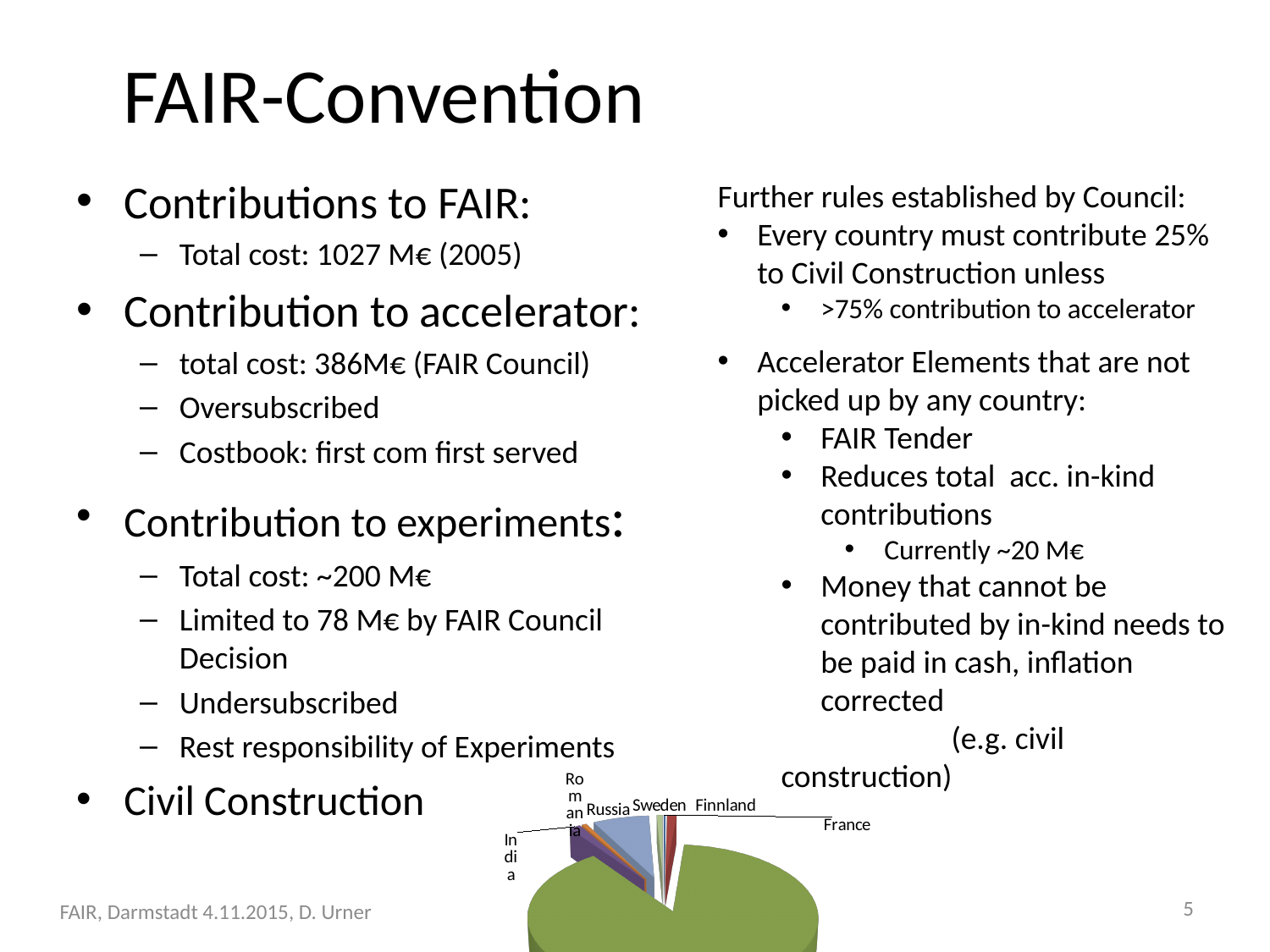
Which country label appears at the far right of the pie chart? France What kind of chart is shown at the bottom of the slide? pie chart Which country label appears at the far left of the pie chart? India In the pie chart, which slice is larger, Russia or Sweden? Russia